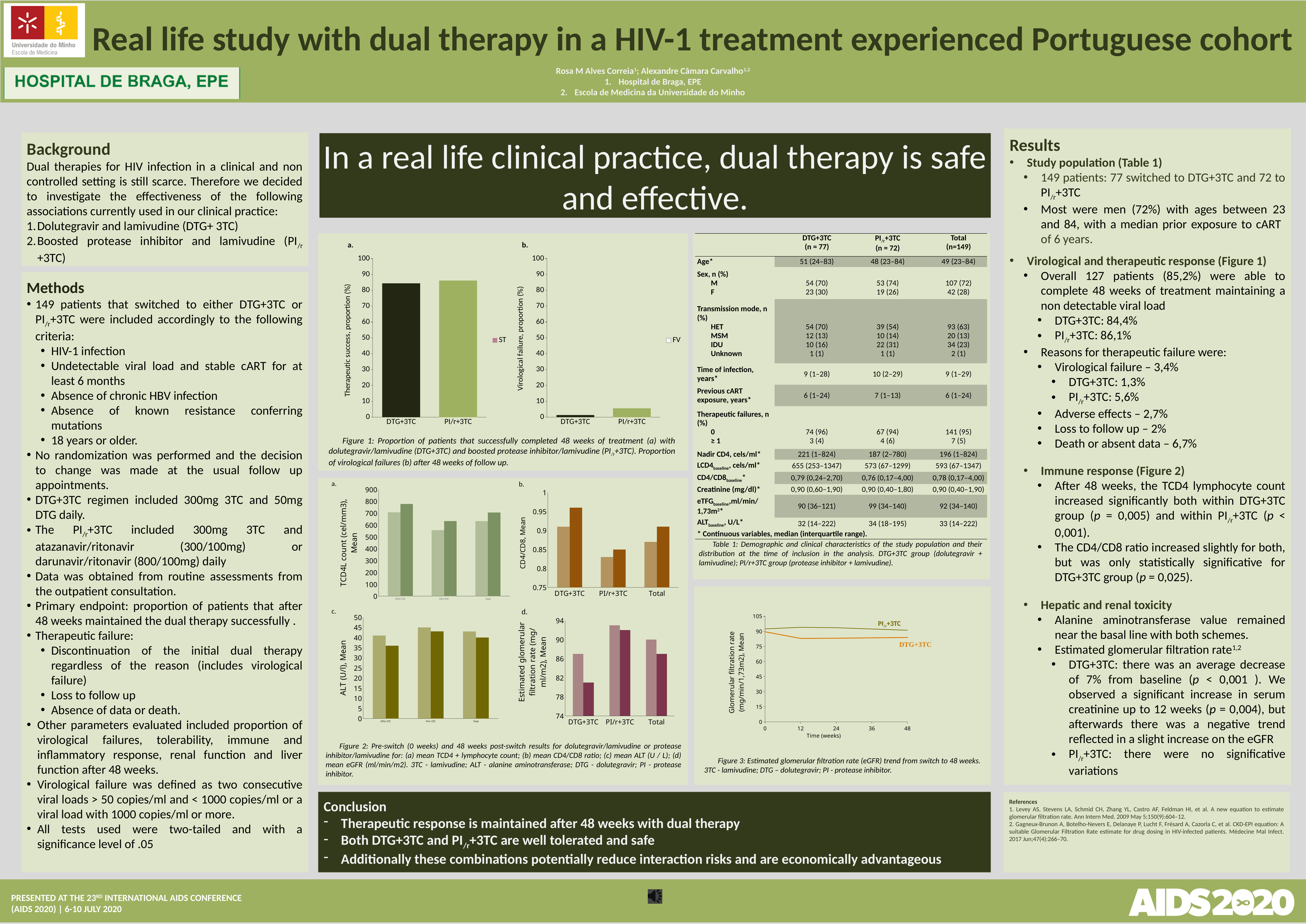
In Figure 1a (Therapeutic success), what entry does the legend show? ST In Figure 2a (TCD4L count), how many categories are shown on the x axis? 3 In Figure 1a (Therapeutic success), what kind of chart is shown? bar chart In Figure 1a (Therapeutic success), is the value for DTG+3TC greater or less than 80? greater In Figure 3 (Glomerular filtration rate), what is the title of the x axis? Time (weeks) In Figure 3 (Glomerular filtration rate), which line is higher at 48 weeks, PI/r+3TC or DTG+3TC? PI/r+3TC In Figure 1a (Therapeutic success), is the value for PI/r+3TC greater or less than 90? less In Figure 1b (Virological failure), which category has the higher value, DTG+3TC or PI/r+3TC? PI/r+3TC In Figure 2c (ALT), is the value of the first (lighter) bar for PI/r+3TC greater or less than 40? greater In Figure 1a (Therapeutic success), how many categories are shown on the x axis? 2 In Figure 3 (Glomerular filtration rate), what kind of chart is shown? line chart